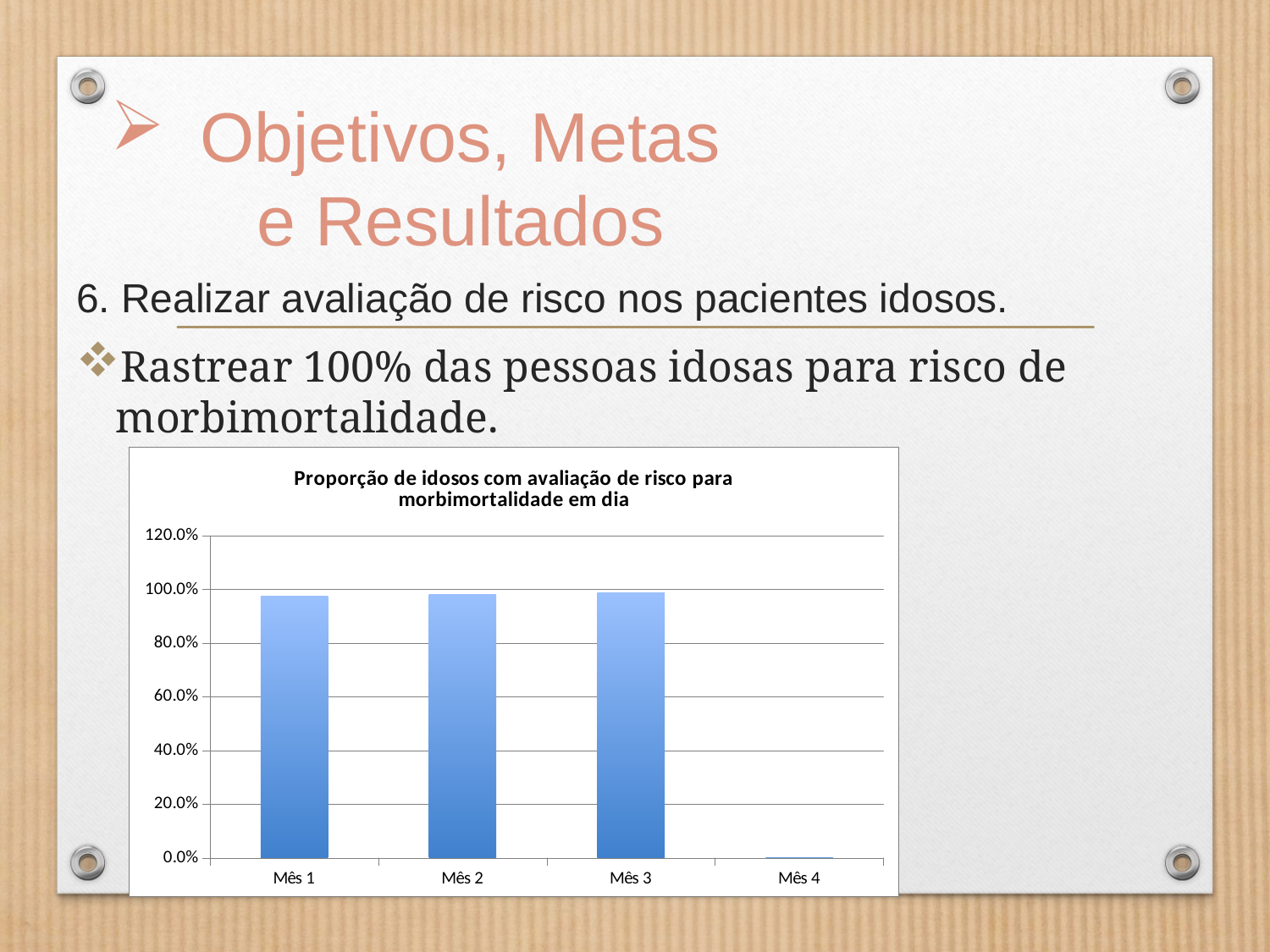
Is the value for Mês 4 greater or less than 20.0%? less What is the highest tick value shown on the y axis of the chart? 120.0% Does the value rise or fall from Mês 3 to Mês 4? fall Which is larger, the value for Mês 1 or the value for Mês 4? Mês 1 Which is larger, the value for Mês 3 or the value for Mês 4? Mês 3 Is the value for Mês 3 greater or less than 60.0%? greater How many months (categories) are shown on the x axis of the chart? 4 Is the value for Mês 1 greater or less than 80.0%? greater Which month has the lowest value in the chart? Mês 4 What is the title of the chart on the slide? Proporção de idosos com avaliação de risco para morbimortalidade em dia What kind of chart is shown on the slide? bar chart